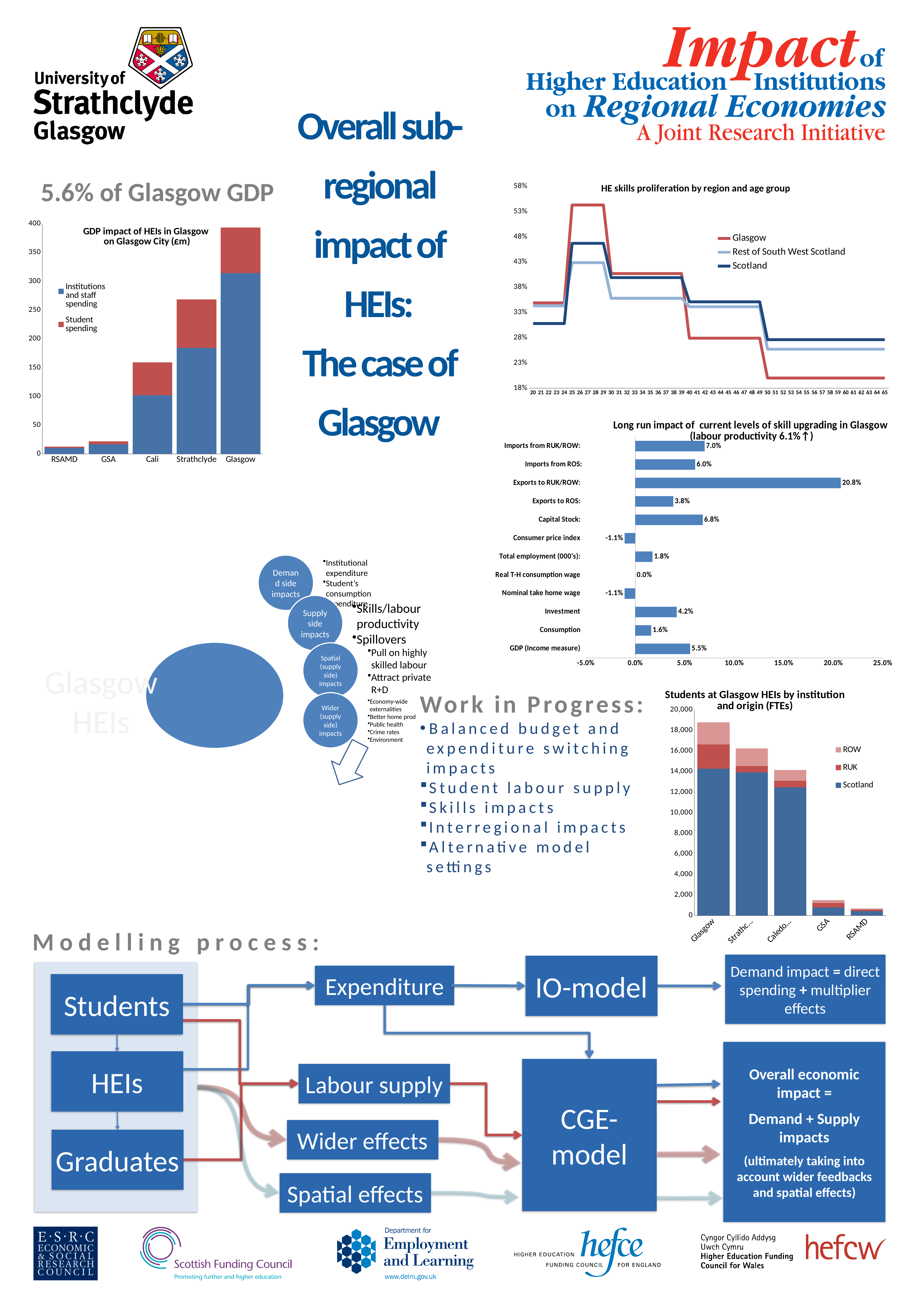
In the chart titled "GDP impact of HEIs in Glasgow on Glasgow City (£m)", which institution has the tallest bar? Glasgow In the chart titled "Long run impact of current levels of skill upgrading in Glasgow", what is the value for Exports to RUK/ROW? 20.8% In the chart titled "Long run impact of current levels of skill upgrading in Glasgow", what is the value for GDP (Income measure)? 5.5% In the chart titled "GDP impact of HEIs in Glasgow on Glasgow City (£m)", is the total bar for Strathclyde greater or less than 200? greater In the chart titled "Students at Glasgow HEIs by institution and origin (FTEs)", which institution has the lowest total? RSAMD In the chart titled "Students at Glasgow HEIs by institution and origin (FTEs)", what are the three series listed in the legend? ROW, RUK, Scotland In the chart titled "Long run impact of current levels of skill upgrading in Glasgow", which category has the highest value? Exports to RUK/ROW What kind of chart is "HE skills proliferation by region and age group"? Line chart How many categories are shown in the chart titled "Long run impact of current levels of skill upgrading in Glasgow"? 12 In the chart titled "Long run impact of current levels of skill upgrading in Glasgow", which is larger: Capital Stock or Investment? Capital Stock How many series does the legend list in the chart titled "HE skills proliferation by region and age group"? 3 In the chart titled "Long run impact of current levels of skill upgrading in Glasgow", what is the difference between Imports from RUK/ROW and Imports from ROS? 1.0%